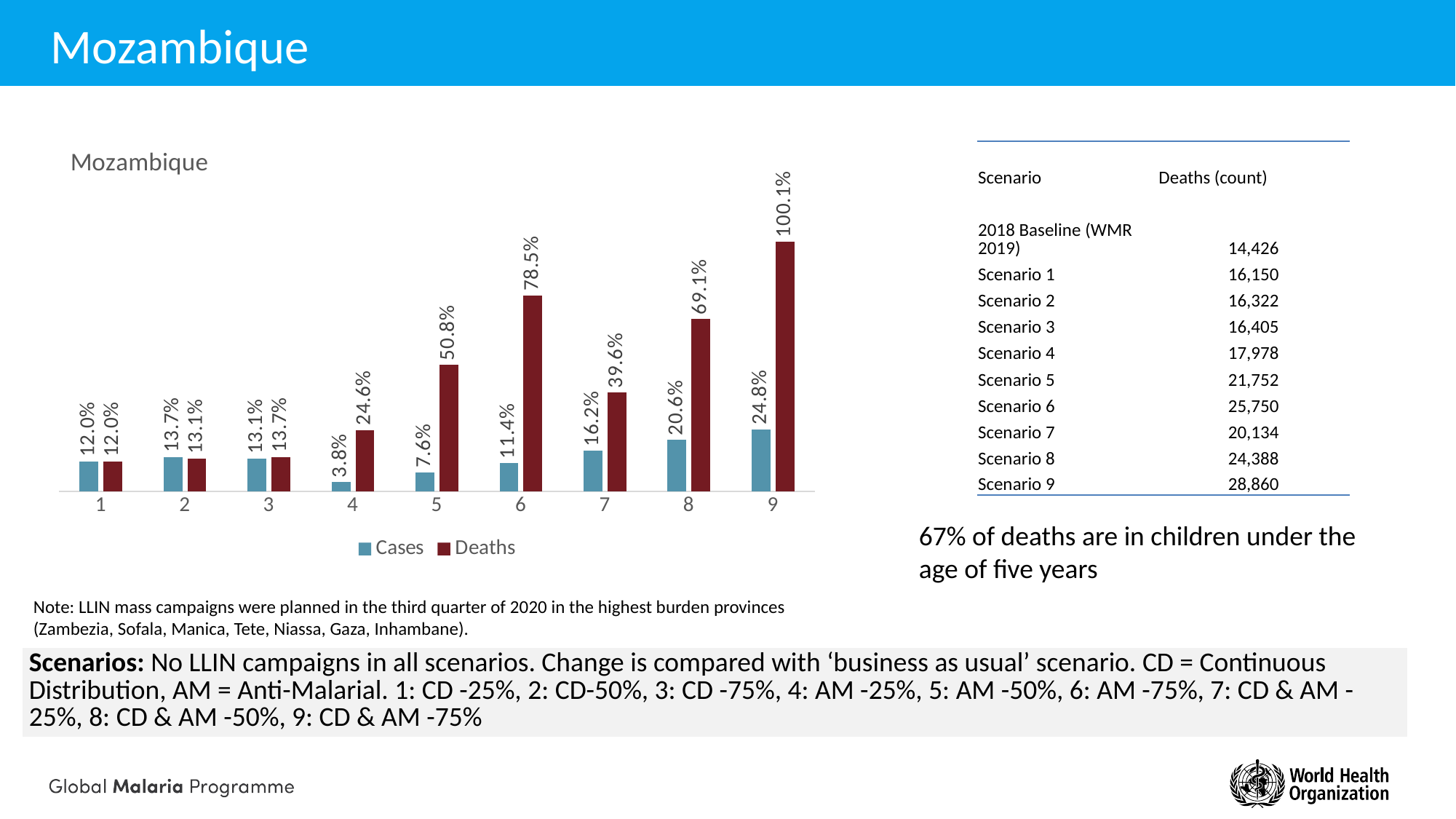
Which is larger for scenario 7: the Cases value or the Deaths value? Deaths What kind of chart is shown on the slide? Bar chart What is the Deaths value for scenario 6? 78.5% Which scenario has the lowest Cases value? 4 What is the Cases value for scenario 8? 20.6% How many scenarios are shown on the x axis of the chart? 9 Which scenario has the highest Deaths value? 9 How many series does the chart legend list? 2 What is the difference between the Deaths value and the Cases value for scenario 5? 43.2% What are the two series named in the chart legend? Cases and Deaths What is the Cases value for scenario 4? 3.8% What is the Deaths value for scenario 9? 100.1%